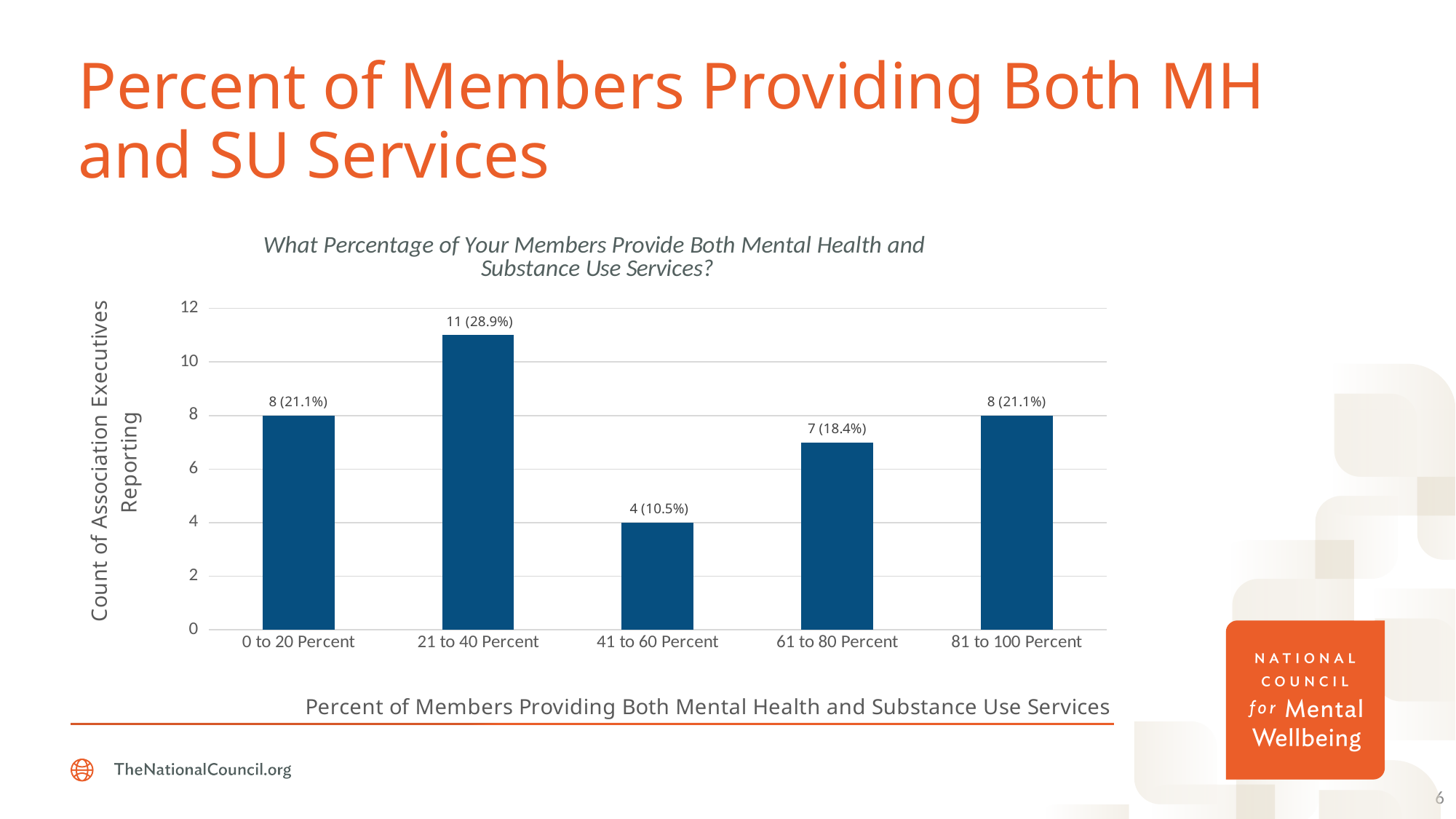
How many association executives reported in the 41 to 60 Percent category? 4 How many categories are shown on the x axis? 5 Is the value for 21 to 40 Percent greater or less than 10? greater Which category has the highest count of association executives reporting? 21 to 40 Percent Which category has the lowest count of association executives reporting? 41 to 60 Percent What is the difference in count between the 21 to 40 Percent and 41 to 60 Percent categories? 7 What is the label of the y axis? Count of Association Executives Reporting What percentage is shown for the 61 to 80 Percent category? 18.4% What is the title of the chart? What Percentage of Your Members Provide Both Mental Health and Substance Use Services? What kind of chart is shown on the slide? Bar chart What is the data label for the 21 to 40 Percent bar? 11 (28.9%) Which has a higher count, 61 to 80 Percent or 81 to 100 Percent? 81 to 100 Percent